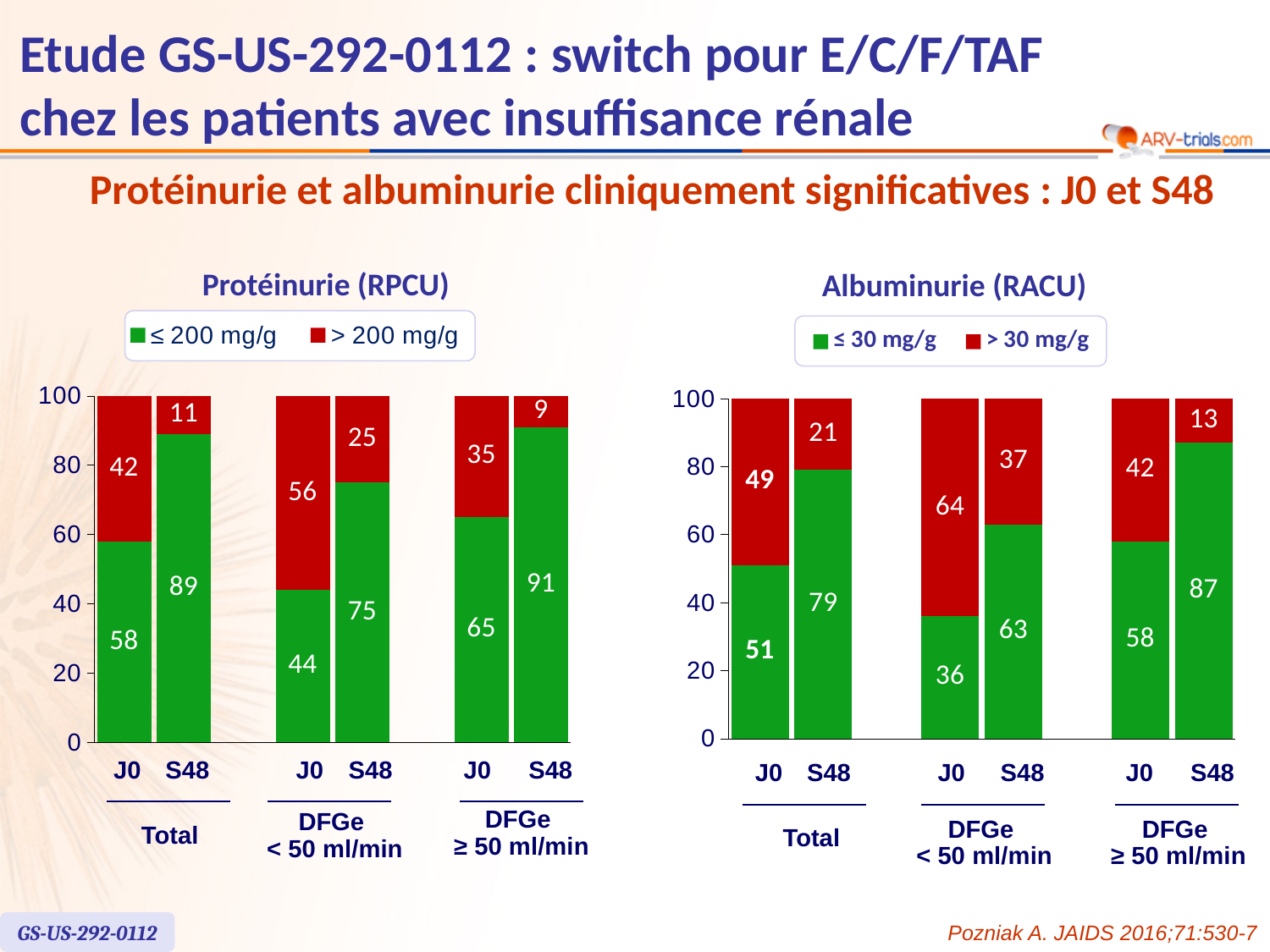
In the Protéinurie (RPCU) chart, which bar has the highest ≤ 200 mg/g value? DFGe ≥ 50 ml/min S48 What type of chart is the Protéinurie (RPCU) chart? Stacked bar chart In the Albuminurie (RACU) chart, what is the total of the stacked bar for DFGe < 50 ml/min at S48? 100 In the Albuminurie (RACU) chart, what is the value of the ≤ 30 mg/g segment for DFGe < 50 ml/min at J0? 36 In the Albuminurie (RACU) chart, which bar has the lowest ≤ 30 mg/g value? DFGe < 50 ml/min J0 How many series does the legend of the Protéinurie (RPCU) chart list? 2 In the Protéinurie (RPCU) chart, what is the value of the ≤ 200 mg/g segment for Total at S48? 89 In the Protéinurie (RPCU) chart, what is the value of the > 200 mg/g segment for DFGe < 50 ml/min at J0? 56 In the Protéinurie (RPCU) chart, what is the difference between the ≤ 200 mg/g values for Total at S48 and at J0? 31 How many bars are plotted in the Albuminurie (RACU) chart? 6 In the Albuminurie (RACU) chart, which is larger: the > 30 mg/g value for Total at J0 or for DFGe ≥ 50 ml/min at J0? Total at J0 In the Albuminurie (RACU) chart, what is the value of the > 30 mg/g segment for DFGe ≥ 50 ml/min at S48? 13